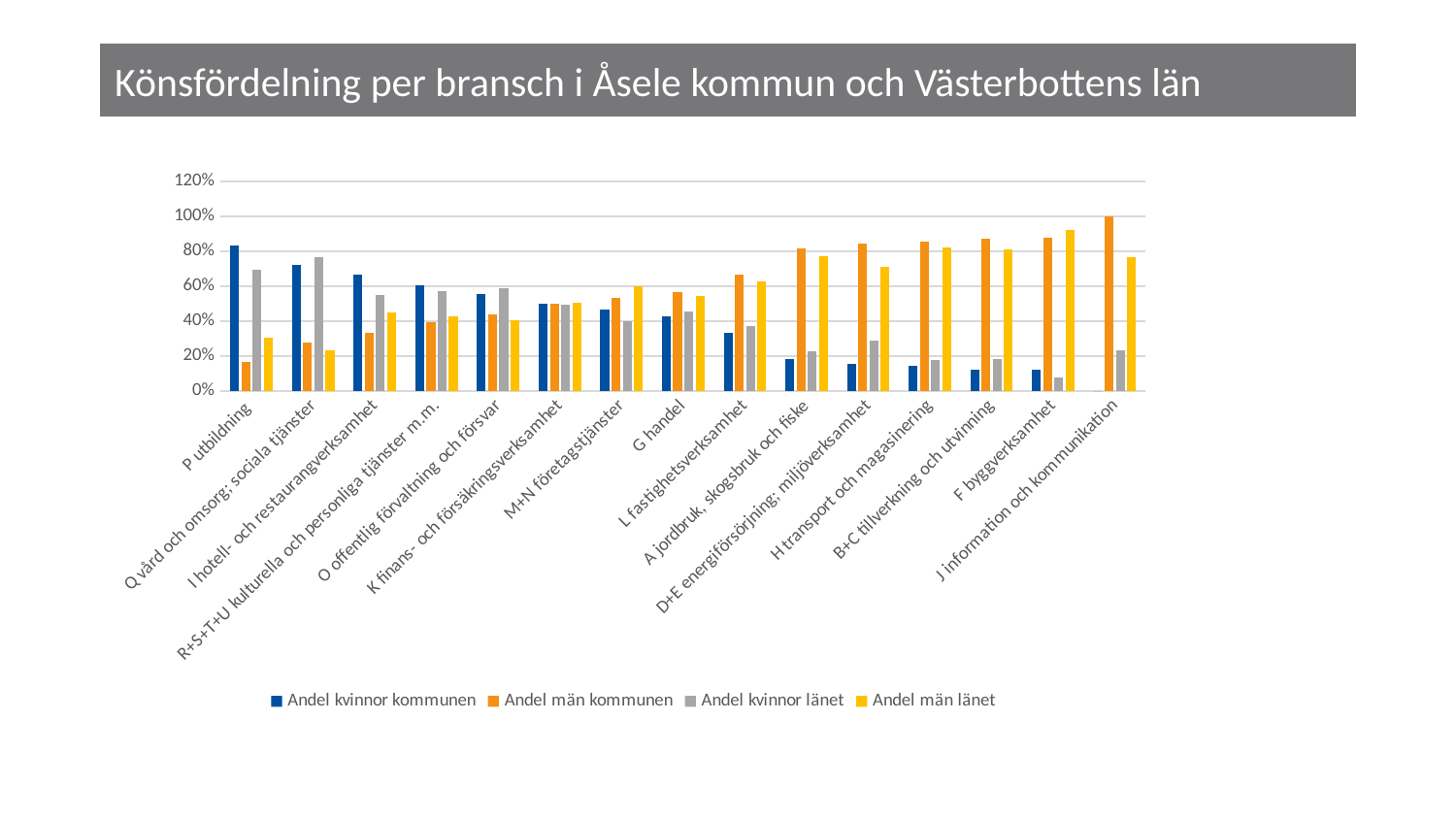
For P utbildning, which is larger: Andel kvinnor kommunen or Andel kvinnor länet? Andel kvinnor kommunen How many industry categories are shown on the x axis? 15 What kind of chart is shown on the slide? bar chart Which category has the highest value for Andel män kommunen? J information och kommunikation Which category has the highest value for Andel kvinnor kommunen? P utbildning How many series does the legend list? 4 For G handel, which is larger: Andel män kommunen or Andel kvinnor kommunen? Andel män kommunen Is the value for Andel män kommunen in Q vård och omsorg; sociala tjänster greater or less than 20%? greater Is the value for Andel kvinnor kommunen in P utbildning greater or less than 60%? greater Do the values for Andel män kommunen generally rise or fall from left to right along the x axis? rise Is the value for Andel män kommunen in A jordbruk, skogsbruk och fiske greater or less than 60%? greater